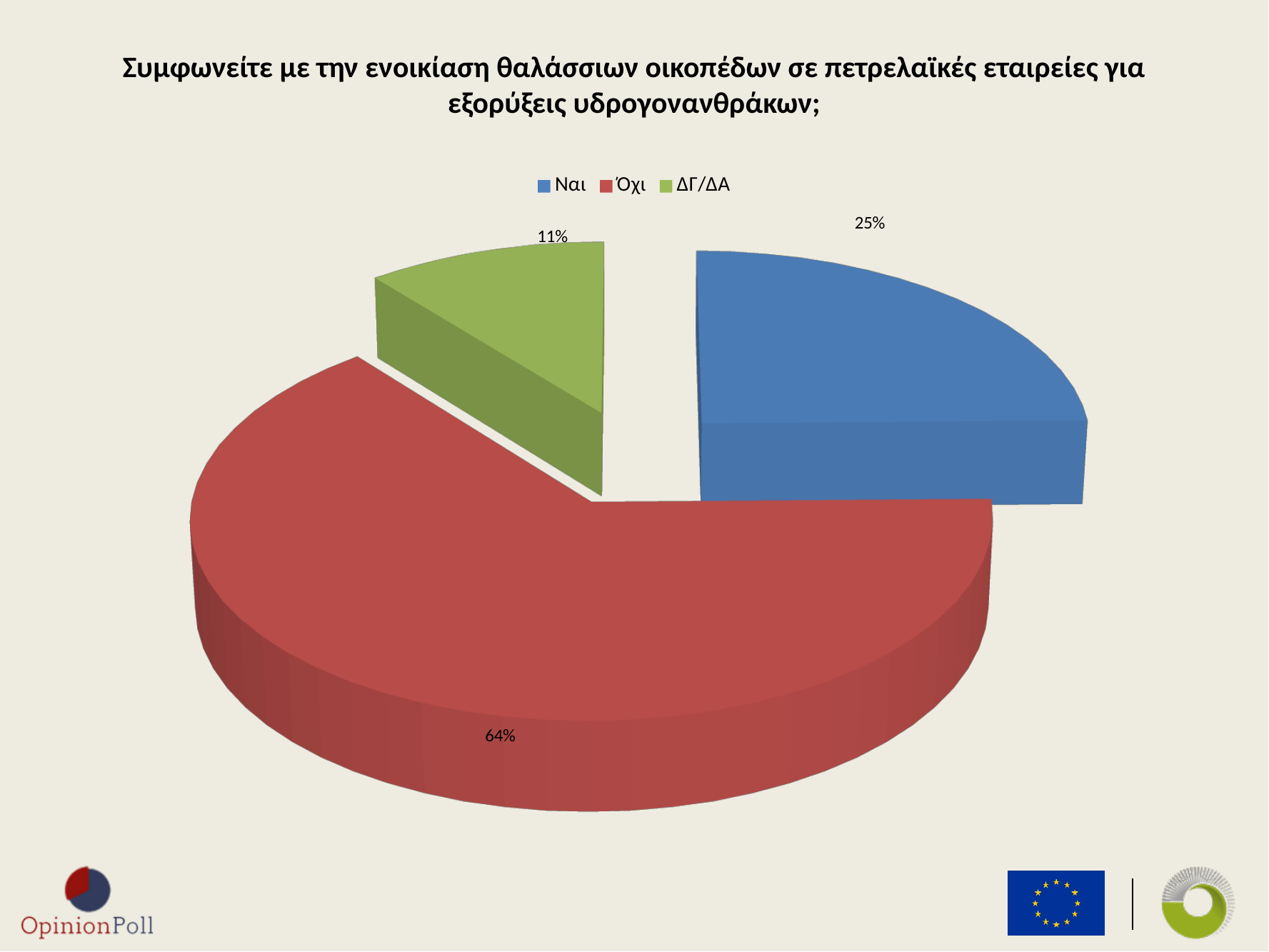
What percentage of respondents answered Όχι? 64% What percentage of respondents answered ΔΓ/ΔΑ? 11% Which response has the largest share of the pie? Όχι Which response has the smallest share of the pie? ΔΓ/ΔΑ What is the difference in percentage points between Όχι and Ναι? 39 What is the difference in percentage points between Ναι and ΔΓ/ΔΑ? 14 How many entries does the legend list? 3 What colour is the slice for Όχι? Red What percentage of respondents answered Ναι? 25% Which is larger, the share for Ναι or the share for ΔΓ/ΔΑ? Ναι How many slices does the pie chart have? 3 What kind of chart is shown on the slide? Pie chart